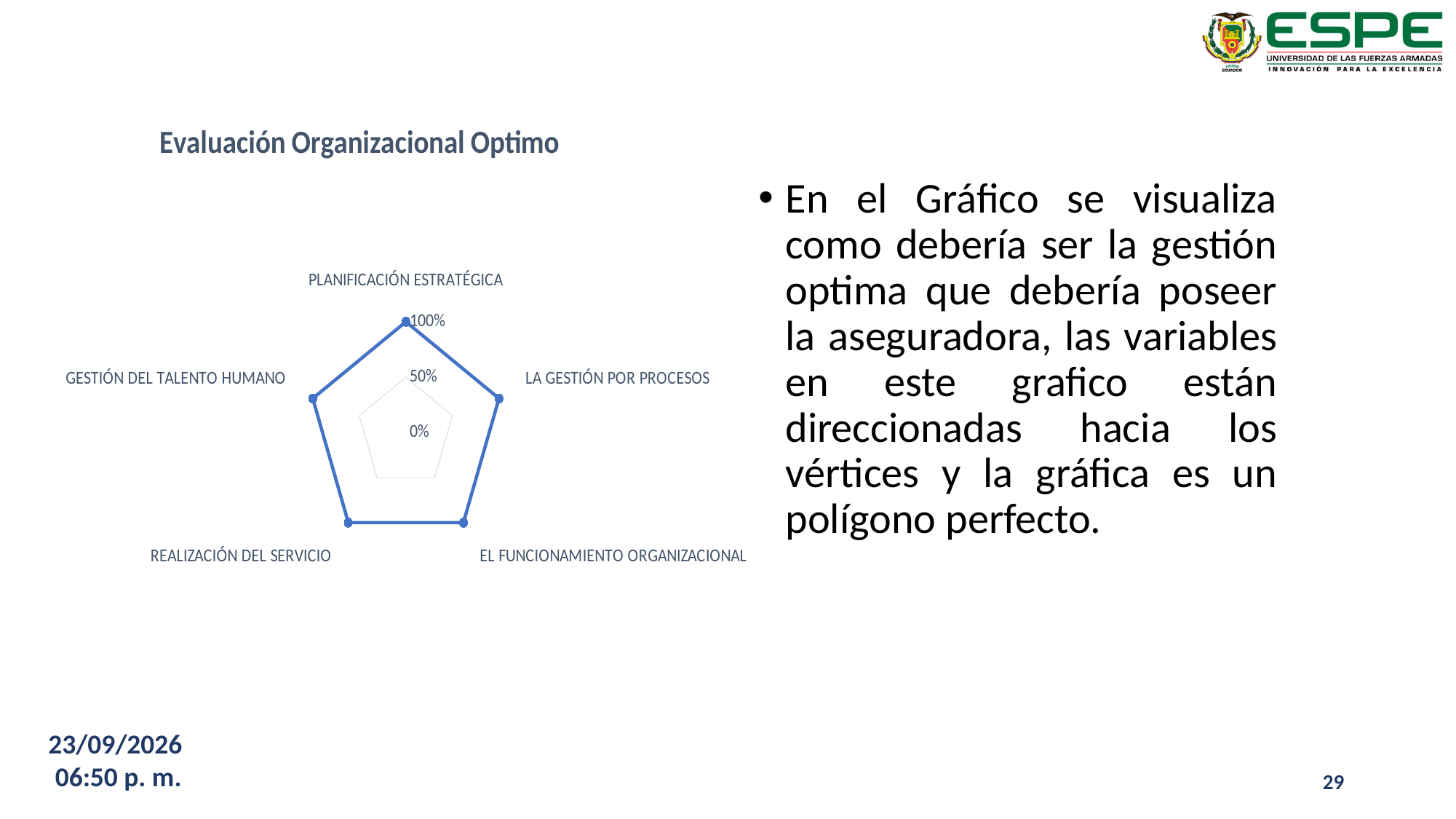
Is the value for REALIZACIÓN DEL SERVICIO greater or less than 50%? greater What is the value for EL FUNCIONAMIENTO ORGANIZACIONAL? 100% What is the value for LA GESTIÓN POR PROCESOS? 100% What is the value for REALIZACIÓN DEL SERVICIO? 100% What is the highest value shown on the radar chart's axis scale? 100% What is the title of the chart? Evaluación Organizacional Optimo What is the value for PLANIFICACIÓN ESTRATÉGICA? 100% What kind of chart is shown on the slide? Radar chart Which category label appears at the top of the radar chart? PLANIFICACIÓN ESTRATÉGICA What is the value for GESTIÓN DEL TALENTO HUMANO? 100% How many categories (axes) does the radar chart have? 5 What is the difference between the values for PLANIFICACIÓN ESTRATÉGICA and LA GESTIÓN POR PROCESOS? 0%